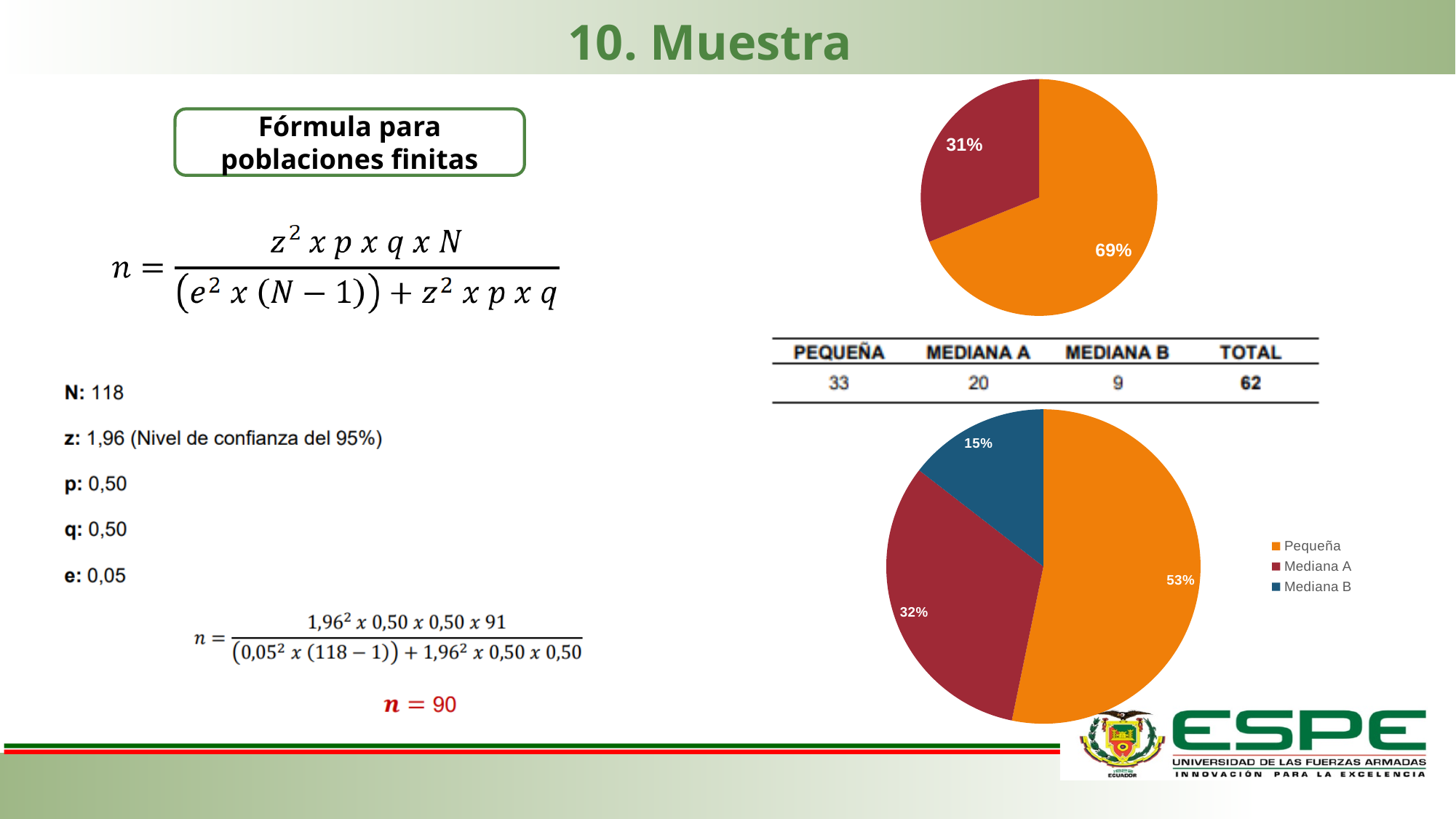
In the lower pie chart, which category has the smallest share? Mediana B In the upper pie chart, what percentage is shown on the largest slice? 69% How many categories does the legend of the lower pie chart list? 3 In the lower pie chart, what colour is the slice for Mediana B? blue In the lower pie chart, what percentage is shown for Pequeña? 53% What type of chart is the lower chart on the right side of the slide? pie chart In the lower pie chart, which category has the largest share? Pequeña In the lower pie chart, what percentage is shown for Mediana B? 15% In the lower pie chart, what percentage is shown for Mediana A? 32% In the lower pie chart, what is the difference in percentage points between Pequeña and Mediana A? 21 In the lower pie chart, which is larger, the share for Mediana A or the share for Mediana B? Mediana A How many slices does the upper pie chart have? 2